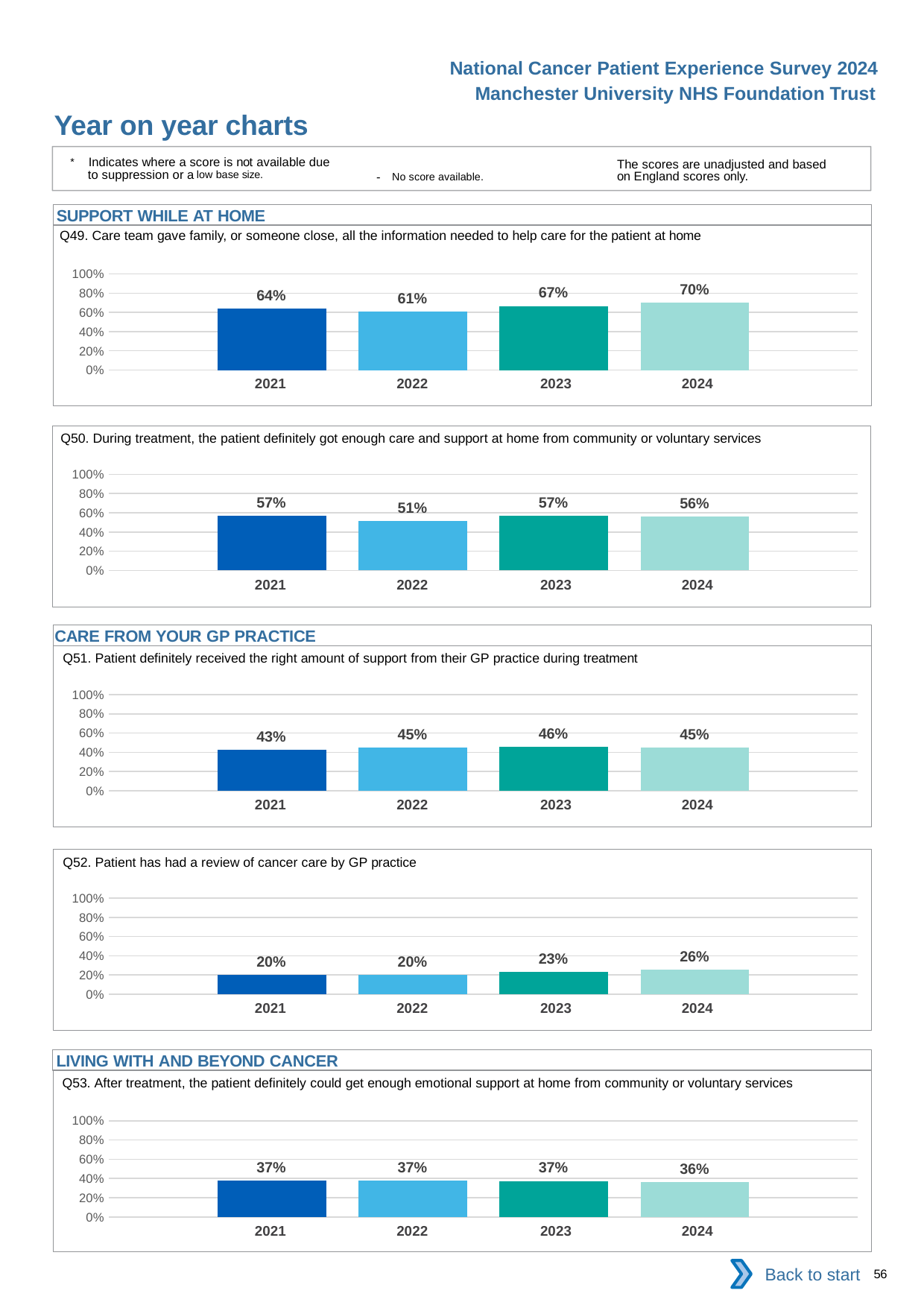
In the Q50 chart, what is the difference between the 2021 and 2022 values? 6 percentage points In the Q51 chart, what is the value for 2021? 43% What type of chart is used for Q52? bar chart In the Q53 chart, is the value for 2021 larger or smaller than the value for 2024? larger In the Q50 chart, what is the value for 2022? 51% In the Q49 chart, what is the value for 2024? 70% In the Q52 chart, do the values rise or fall from 2022 to 2024? rise In the Q53 chart, what is the value for 2024? 36% In the Q52 chart, what is the value for 2024? 26% How many years are shown in the Q49 chart? 4 In the Q51 chart, which year has the highest value? 2023 In the Q49 chart, which year has the lowest value? 2022